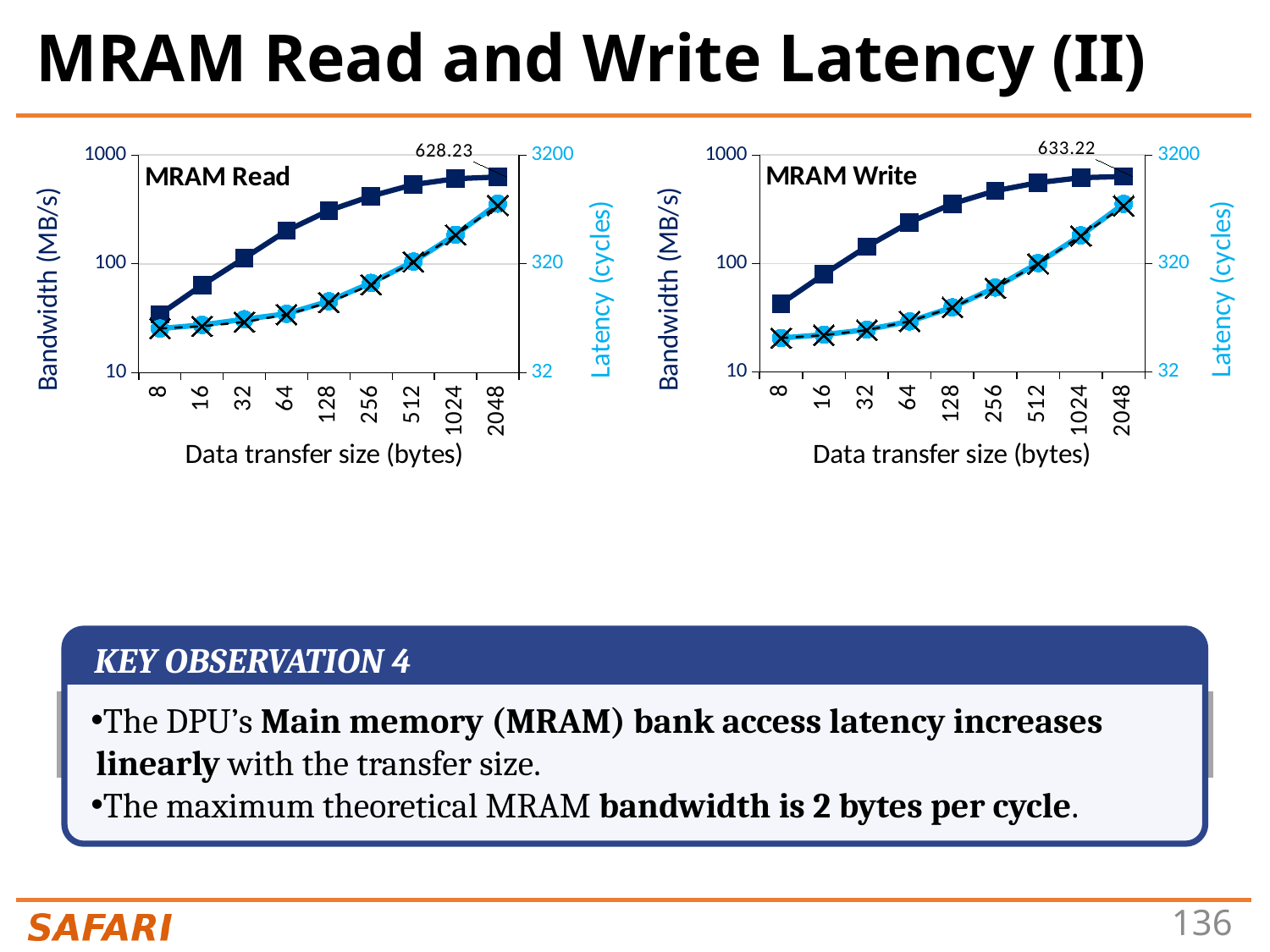
In the MRAM Read chart, is the bandwidth at 8 bytes greater or less than 100 MB/s? less In the MRAM Read chart, what is the labelled bandwidth value at a data transfer size of 2048 bytes? 628.23 In the MRAM Write chart, is the latency at 2048 bytes greater or less than 320 cycles? greater In the MRAM Read chart, does bandwidth rise or fall as the data transfer size increases? Rise In the MRAM Write chart, at which data transfer size is bandwidth highest? 2048 What is the label of the right-hand y axis in the MRAM Read chart? Latency (cycles) In the MRAM Read chart, at which data transfer size is bandwidth lowest? 8 How many data transfer sizes are shown on the x axis of the MRAM Read chart? 9 What is the difference between the labelled bandwidth at 2048 bytes in the MRAM Write chart and in the MRAM Read chart? 4.99 What kind of chart is the MRAM Write chart? Line chart In the MRAM Write chart, what is the labelled bandwidth value at a data transfer size of 2048 bytes? 633.22 Which chart shows the higher labelled bandwidth at 2048 bytes, MRAM Read or MRAM Write? MRAM Write